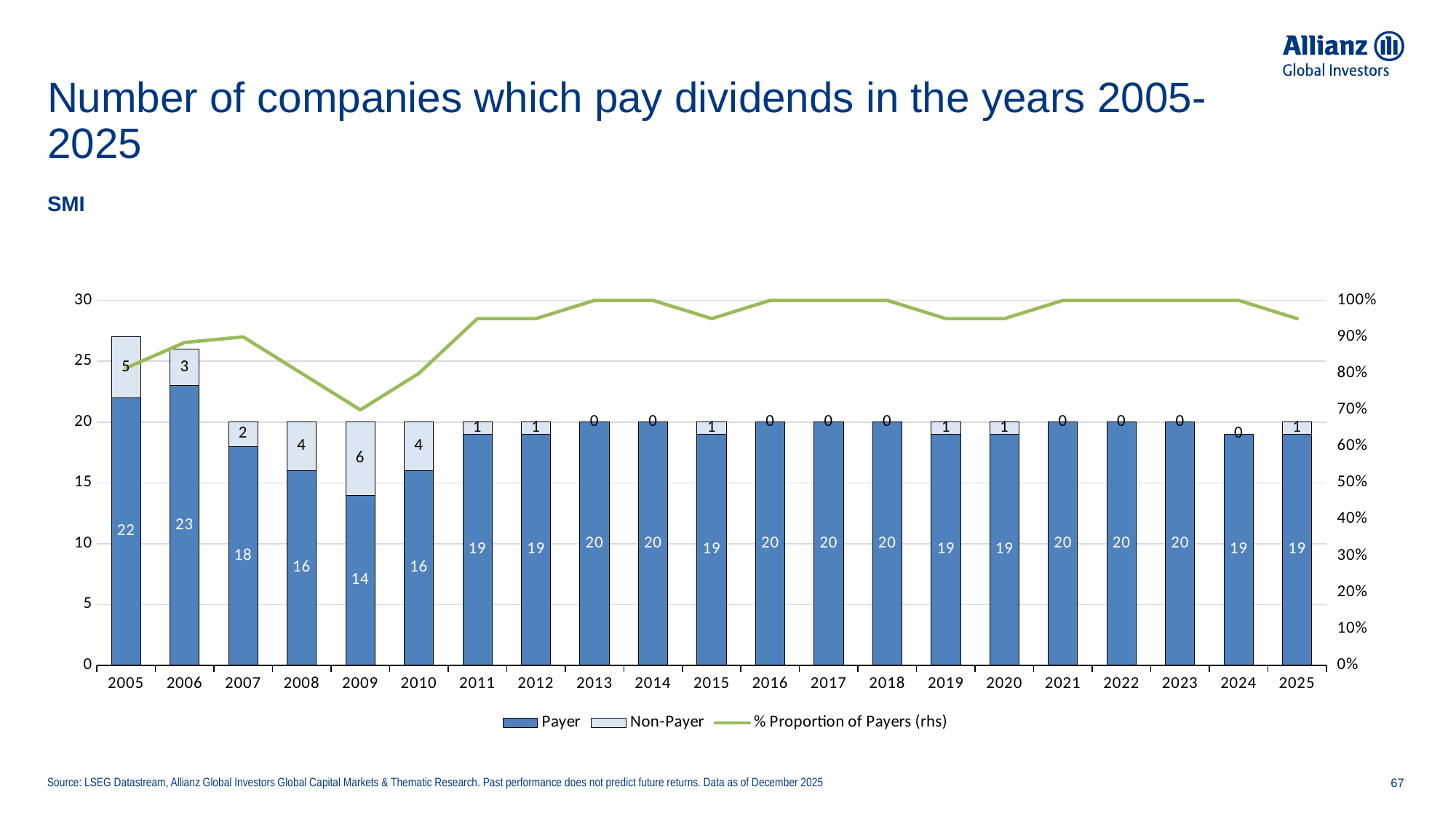
What is the subtitle shown above the chart? SMI Which year has the highest Payer value? 2006 What is the Non-Payer value for 2005? 5 What is the difference between the Payer values for 2006 and 2009? 9 What is the Payer value for 2009? 14 Which year has the lowest Payer value? 2009 What is the total of the stacked bar (Payer plus Non-Payer) for 2005? 27 How many series does the legend list? 3 What kind of chart is shown on the slide? Combined stacked bar and line chart Is the % Proportion of Payers for 2009 greater or less than 80%? less Which is larger, the Non-Payer value for 2009 or the Non-Payer value for 2010? 2009 How many years are shown on the x axis? 21